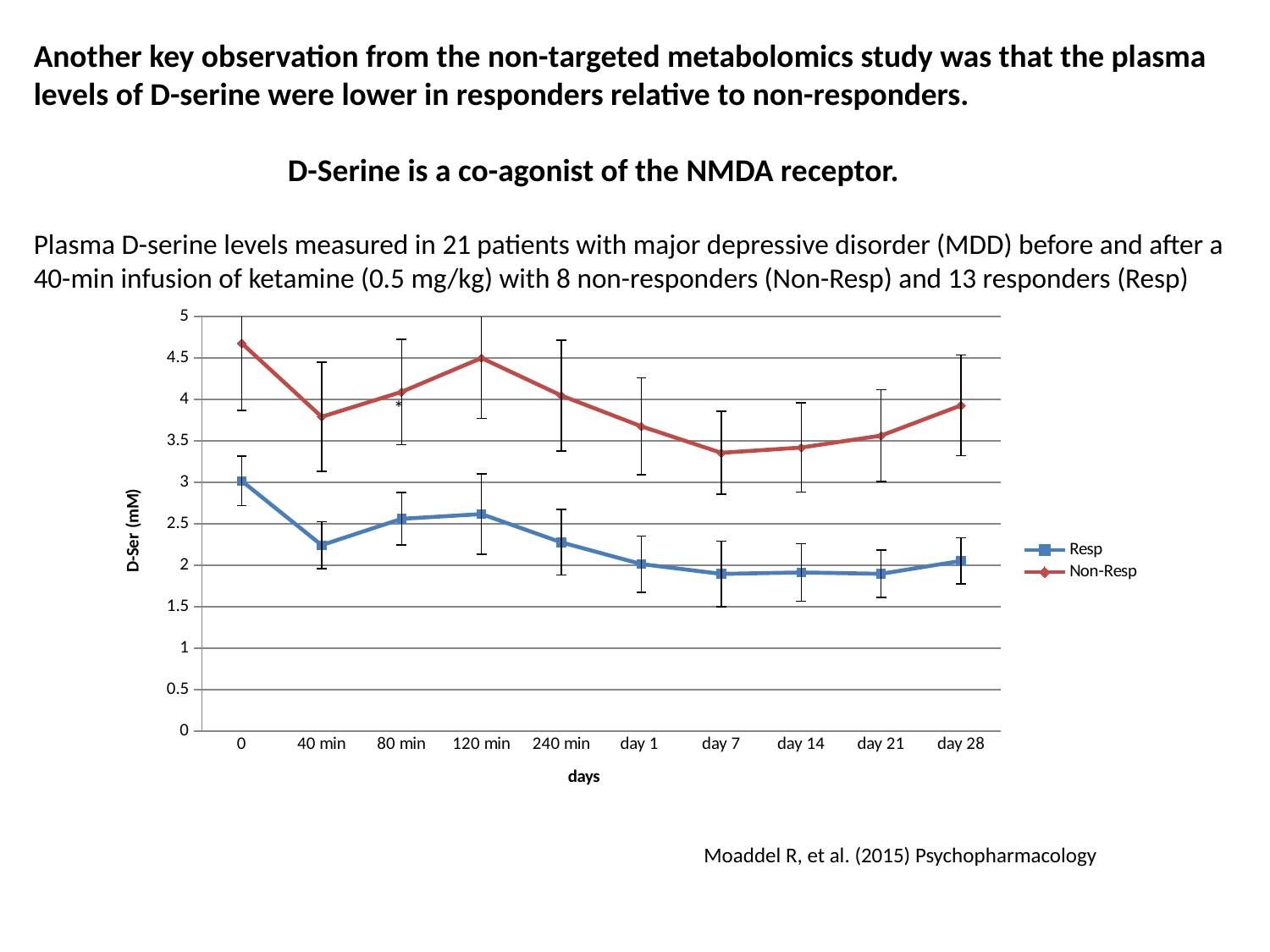
At which time point is the Non-Resp series highest? 0 Is the Resp value at day 7 greater or less than 2? less Which series has the higher D-Ser value at day 28, Resp or Non-Resp? Non-Resp Is the Non-Resp value at 0 greater or less than 4.5? greater Does the Resp series rise or fall from 0 to day 7? fall What is the label of the y axis? D-Ser (mM) Is the Resp value at 40 min greater or less than 2.5? less At which time point is the Resp series highest? 0 How many time points are plotted along the x axis? 10 How many series does the legend list? 2 What kind of chart is shown on the slide? line chart